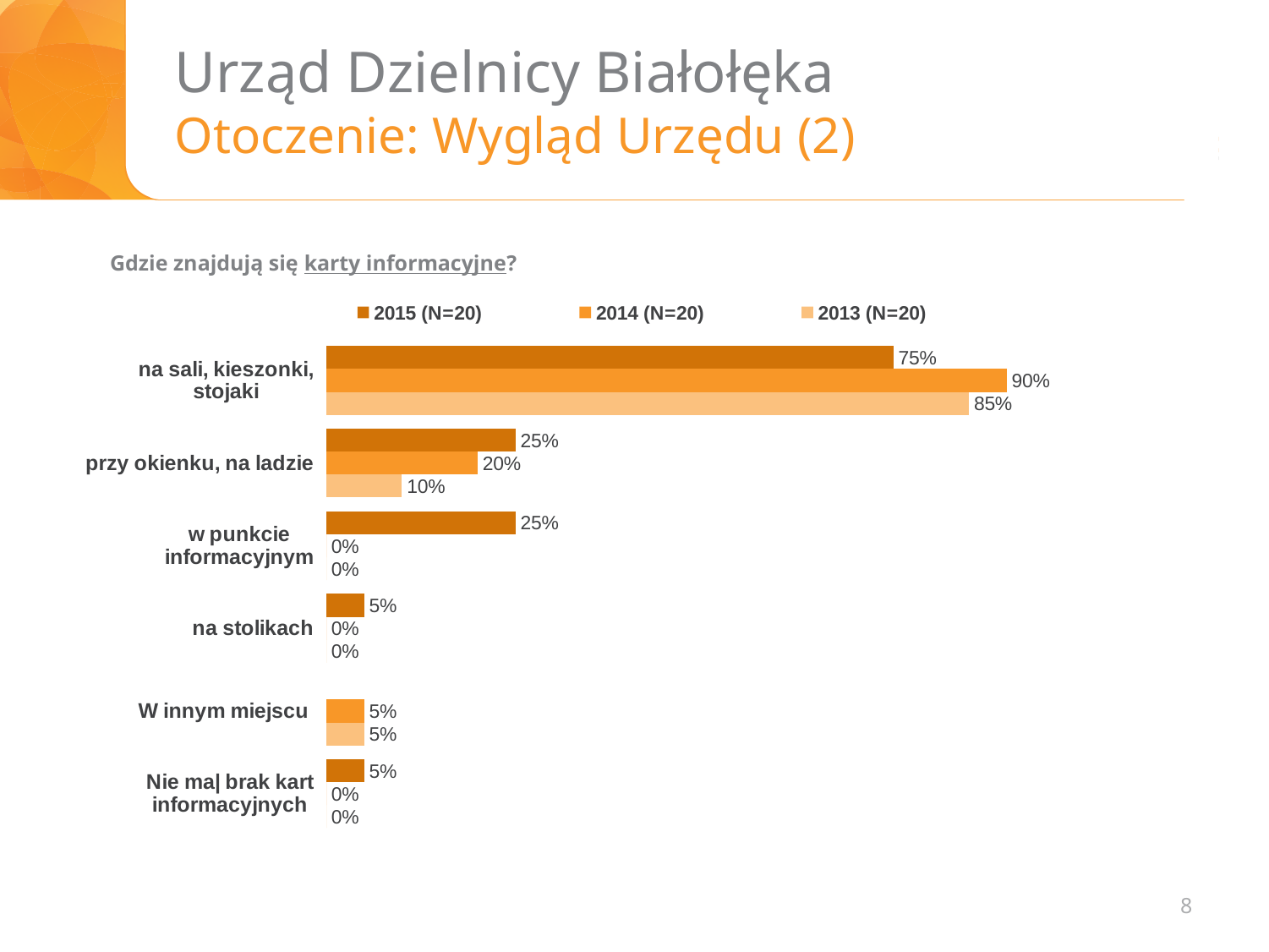
What is the value for 'na sali, kieszonki, stojaki' in the 2014 (N=20) series? 90% Which category has the highest value in the 2015 (N=20) series? na sali, kieszonki, stojaki What kind of chart is shown on the slide? bar chart How many categories are shown on the chart? 6 What question is the chart answering, according to the text above it? Gdzie znajdują się karty informacyjne? What is the value for 'w punkcie informacyjnym' in the 2015 (N=20) series? 25% Which year has the highest value for 'na sali, kieszonki, stojaki'? 2014 (N=20) What is the value for 'na stolikach' in the 2014 (N=20) series? 0% How many series does the legend list? 3 Which is larger for 'przy okienku, na ladzie': the 2015 (N=20) value or the 2013 (N=20) value? 2015 (N=20) What is the difference between the 2014 (N=20) and 2015 (N=20) values for 'na sali, kieszonki, stojaki'? 15% What is the value for 'przy okienku, na ladzie' in the 2013 (N=20) series? 10%